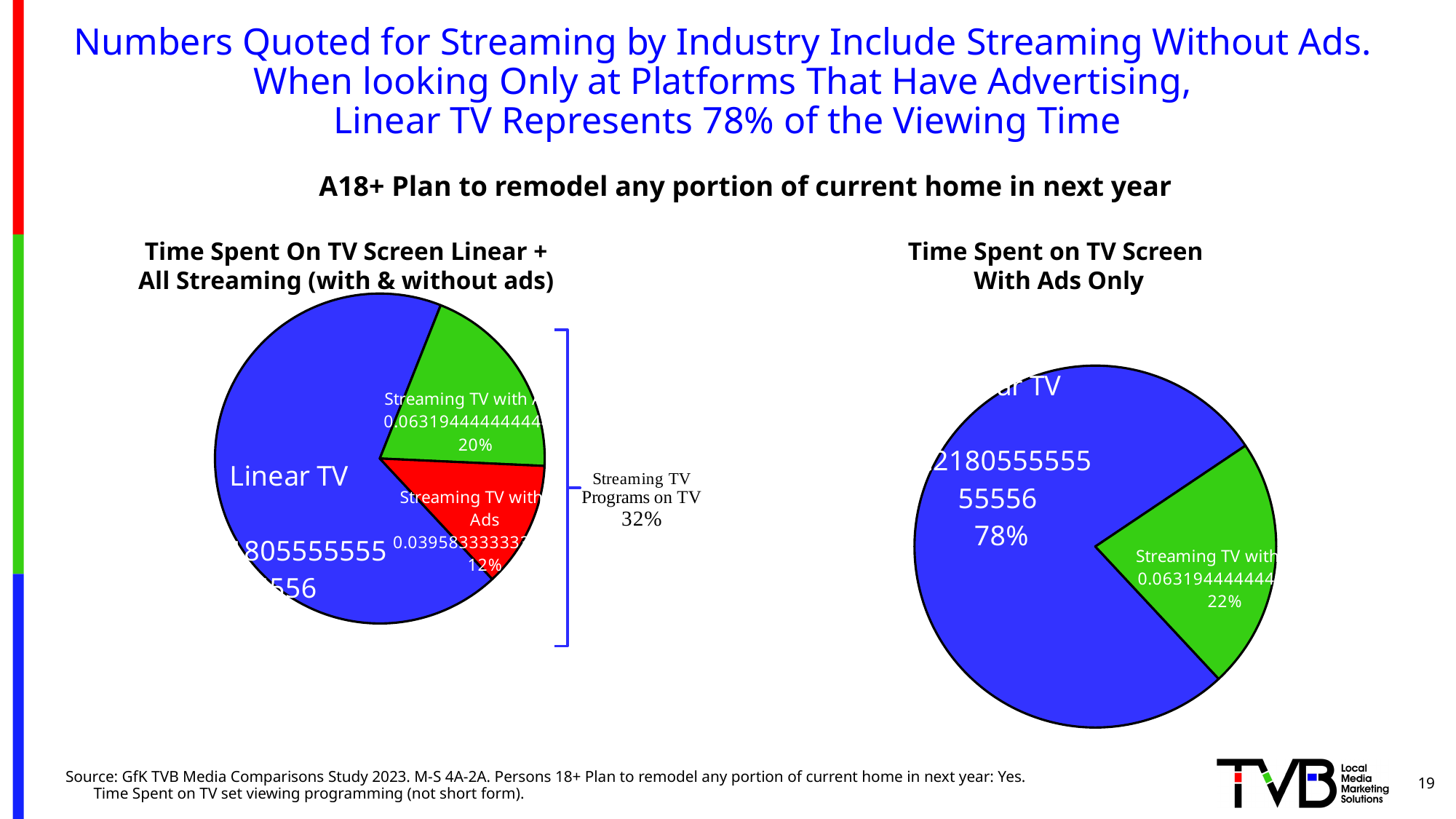
In the 'Time Spent On TV Screen Linear + All Streaming (with & without ads)' chart, how many slices does the pie have? 3 In the 'Time Spent on TV Screen With Ads Only' chart, how many slices does the pie have? 2 In the 'Time Spent on TV Screen With Ads Only' chart, what share does Streaming TV with Ads represent? 22% What colour is the Linear TV slice in the 'Time Spent on TV Screen With Ads Only' chart? blue In the 'Time Spent on TV Screen With Ads Only' chart, what share of viewing time does Linear TV represent? 78% In the 'Time Spent on TV Screen With Ads Only' chart, which slice is the largest? Linear TV In the 'Time Spent On TV Screen Linear + All Streaming (with & without ads)' chart, which slice is the smallest? Streaming TV without Ads What kind of chart is the 'Time Spent on TV Screen With Ads Only' chart? pie chart In the 'Time Spent On TV Screen Linear + All Streaming (with & without ads)' chart, what combined share do the streaming slices (Streaming TV Programs on TV) represent? 32% In the 'Time Spent on TV Screen With Ads Only' chart, what is the difference in percentage points between Linear TV and Streaming TV with Ads? 56 percentage points